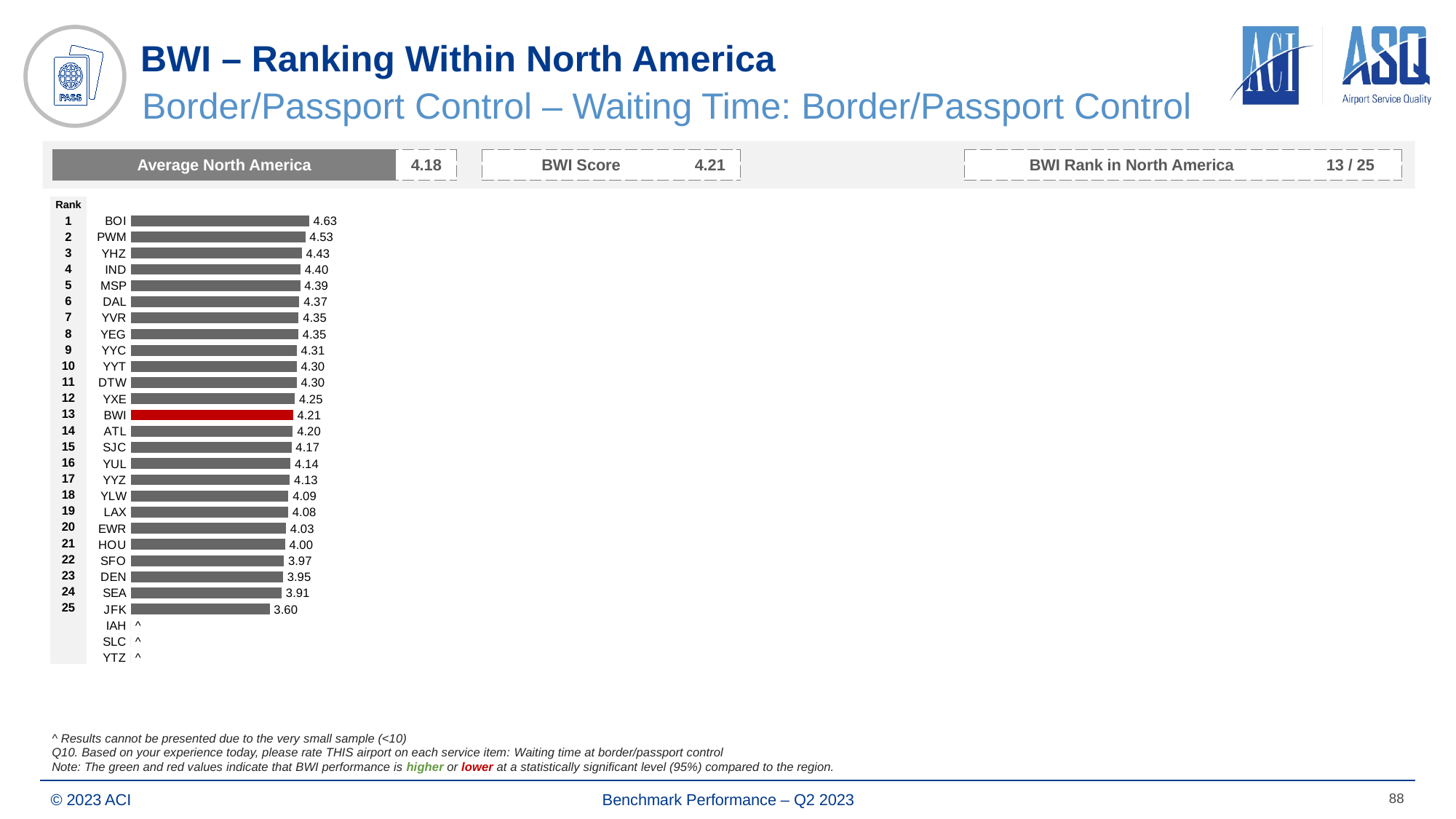
Which airport has the lowest score in the chart? JFK What is the score for JFK? 3.60 Which has a higher score, YHZ or SEA? YHZ What is the score for BWI in the ranking chart? 4.21 What kind of chart is shown on the slide? bar chart Which airport has the highest score in the chart? BOI How many airports have a score shown as a bar in the chart? 25 What is the Average North America score shown on the slide? 4.18 What is the score for DEN? 3.95 Which bar in the chart is coloured red? BWI What is the difference between the scores of ATL and HOU? 0.20 What is the difference between the scores of BOI and BWI? 0.42